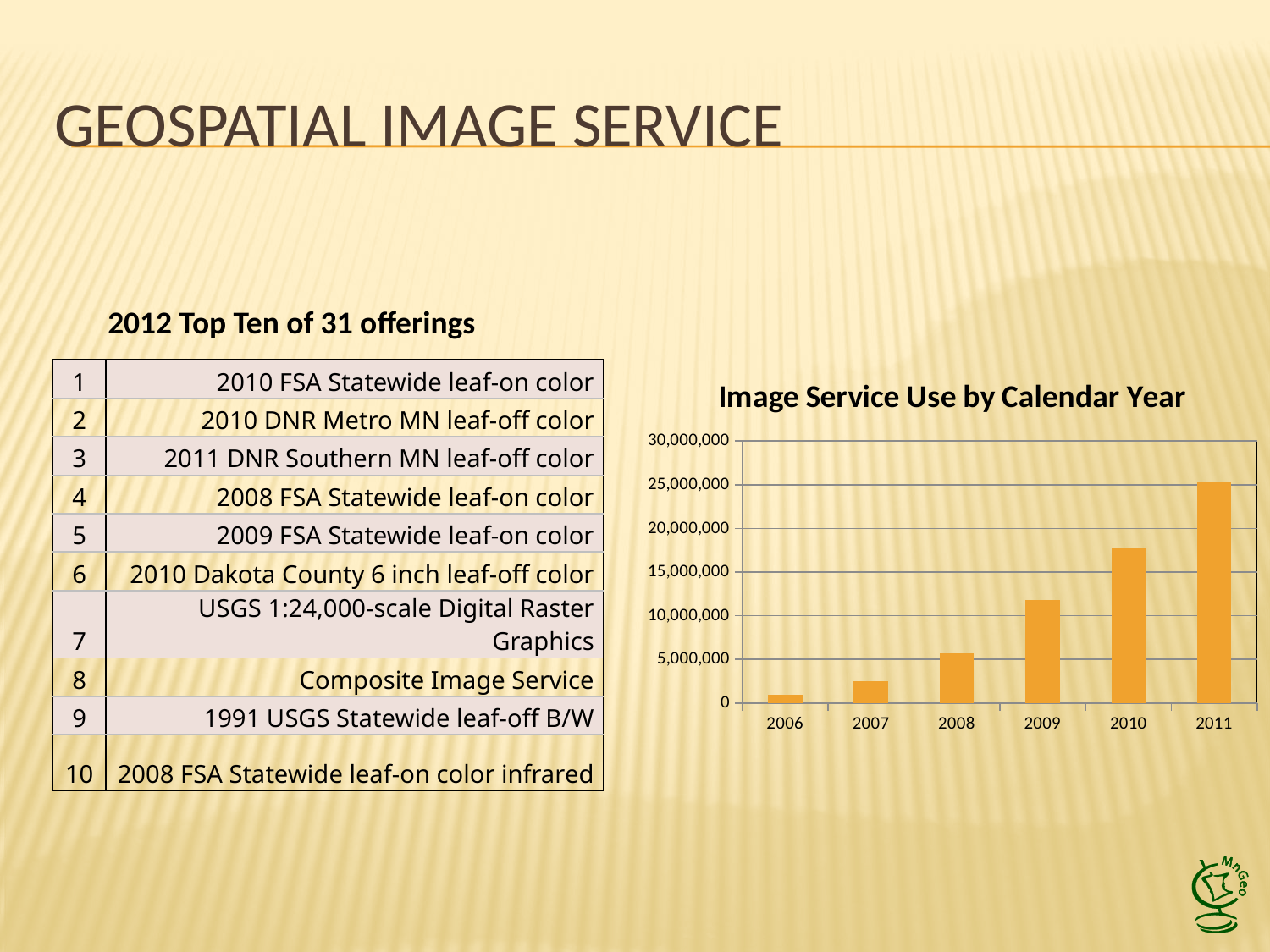
Is the value for 2008 greater or less than 10,000,000? less Do the values in the chart rise or fall from 2006 to 2011? rise Which year has the highest image service use in the chart? 2011 Is the value for 2010 greater or less than 15,000,000? greater Which year has the lowest image service use in the chart? 2006 Is the value for 2011 greater or less than 20,000,000? greater What type of chart is shown on the slide? bar chart How many years are shown on the x axis of the chart? 6 Which year has the larger value in the chart, 2009 or 2010? 2010 What is the title of the chart on the slide? Image Service Use by Calendar Year